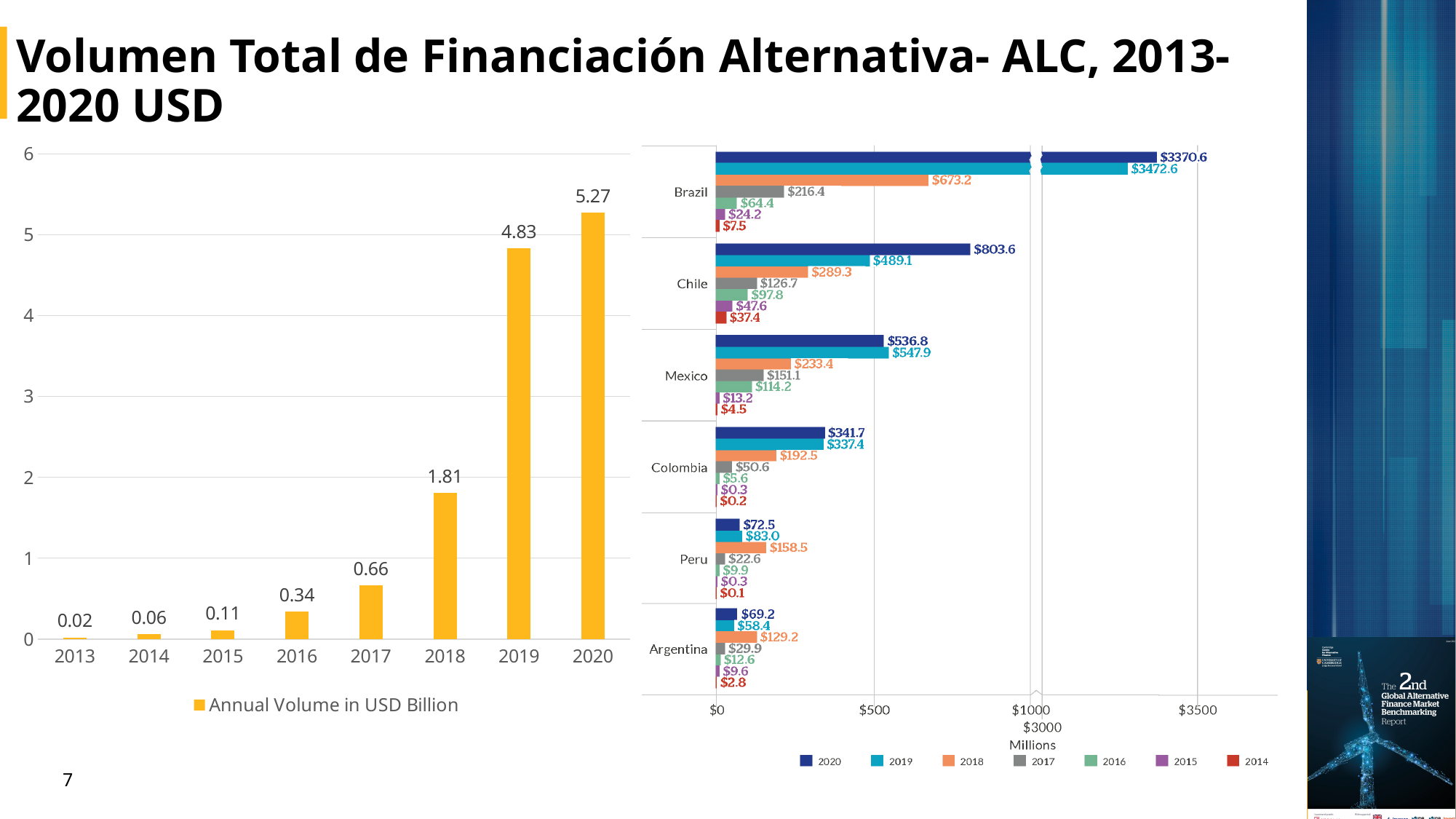
In the right chart, which is larger for Mexico: the 2019 value or the 2020 value? 2019 value In the right chart, how many series does the legend list? 7 In the left chart, do the values rise or fall from 2013 to 2020? rise In the left chart, what is the annual volume in USD billion for 2020? 5.27 In the right chart, which country has the highest 2020 value? Brazil In the left chart, how many years are shown on the x axis? 8 In the left chart, what is the difference between the 2020 and 2019 values? 0.44 In the right chart, what is the 2020 value for Chile? $803.6 What kind of chart is the right chart? bar chart In the right chart, what is the 2018 value for Peru? $158.5 In the left chart, which year has the lowest annual volume? 2013 In the left chart, what is the annual volume in USD billion for 2017? 0.66